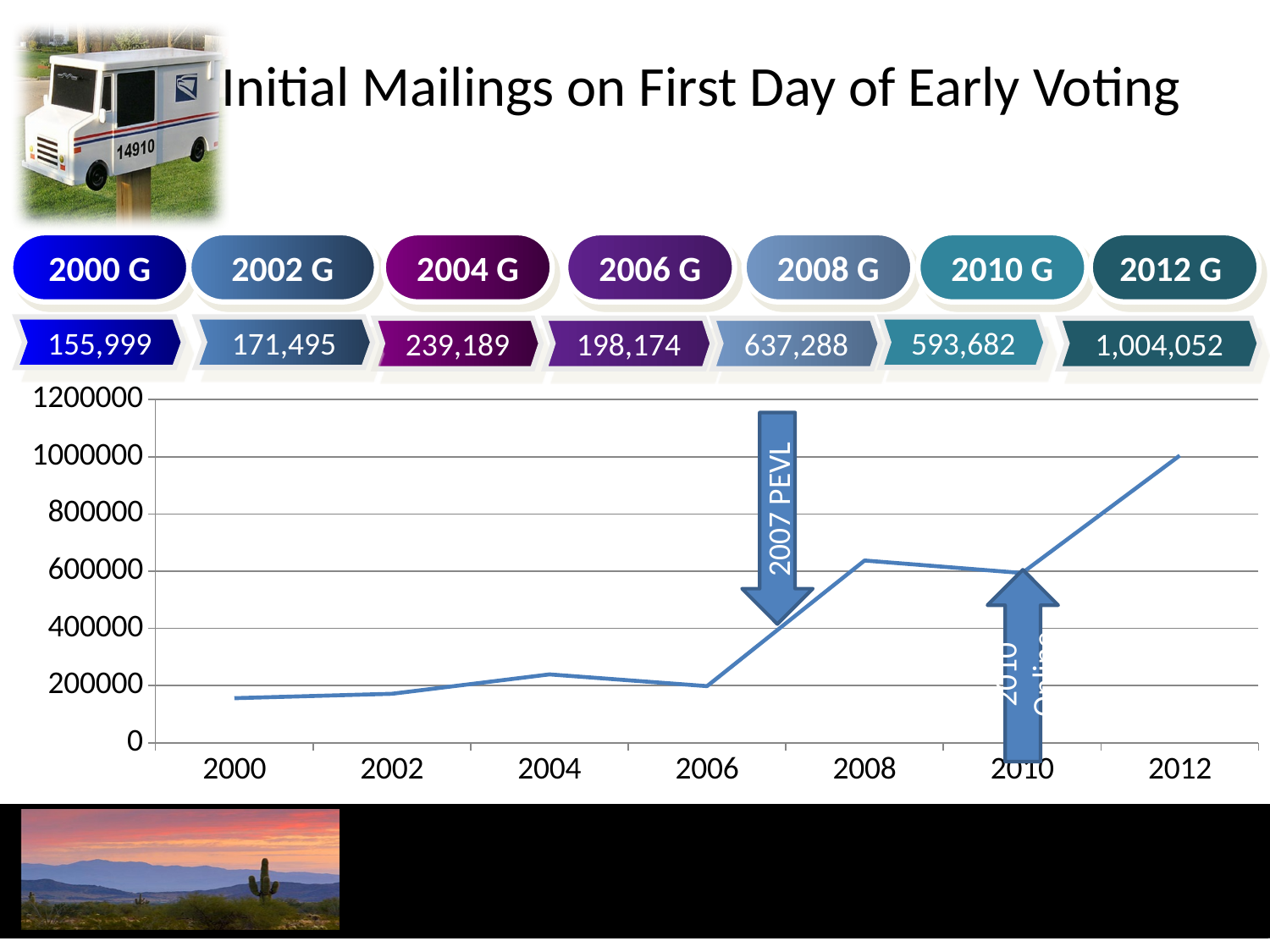
Which year has more initial mailings, 2008 or 2010? 2008 How many years are plotted on the x axis of the chart? 7 What is the value of initial mailings for 2000? 155,999 What kind of chart is shown on the slide? line chart Which year has the lowest number of initial mailings? 2000 Which year has the highest number of initial mailings? 2012 Is the value for 2004 greater or less than 400000? less What is the title of the slide containing the chart? Initial Mailings on First Day of Early Voting What is the value of initial mailings for 2012? 1,004,052 What is the difference in initial mailings between 2008 and 2006? 439,114 Is the value for 2010 greater or less than 400000? greater What is the value of initial mailings for 2008? 637,288